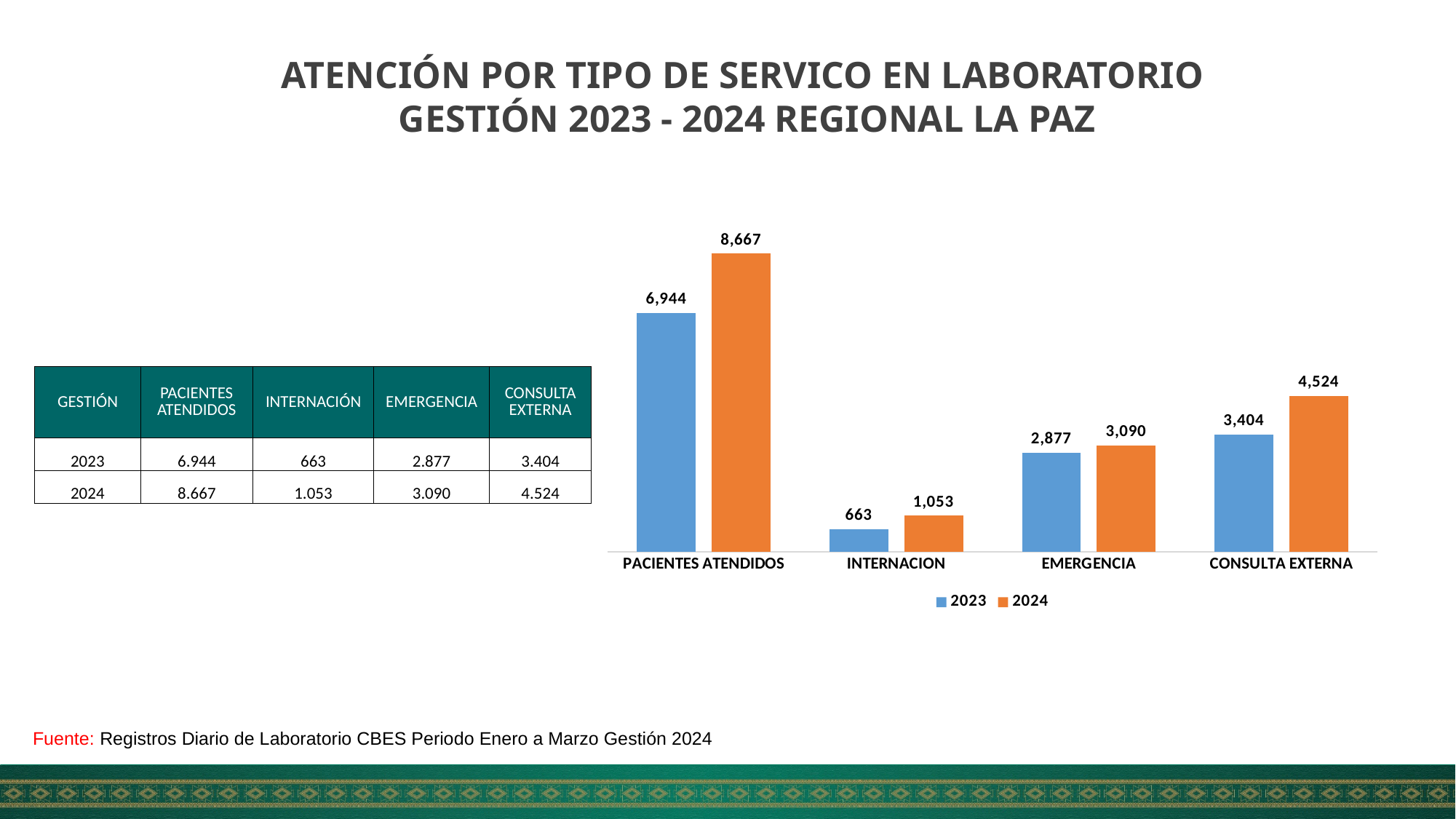
How many series does the chart legend list? 2 What is the value for EMERGENCIA in the 2024 series? 3,090 What is the difference between the 2024 and 2023 values for PACIENTES ATENDIDOS? 1,723 What is the value for CONSULTA EXTERNA in the 2023 series? 3,404 Which category has the highest value in the 2024 series? PACIENTES ATENDIDOS What kind of chart is shown on the slide? Bar chart What is the value for PACIENTES ATENDIDOS in the 2024 series? 8,667 Which is larger: the 2023 value for EMERGENCIA or the 2024 value for INTERNACION? 2023 value for EMERGENCIA What is the difference between the 2024 and 2023 values for CONSULTA EXTERNA? 1,120 How many categories are shown on the x axis of the chart? 4 What is the value for INTERNACION in the 2023 series? 663 Which category has the lowest value in the 2023 series? INTERNACION